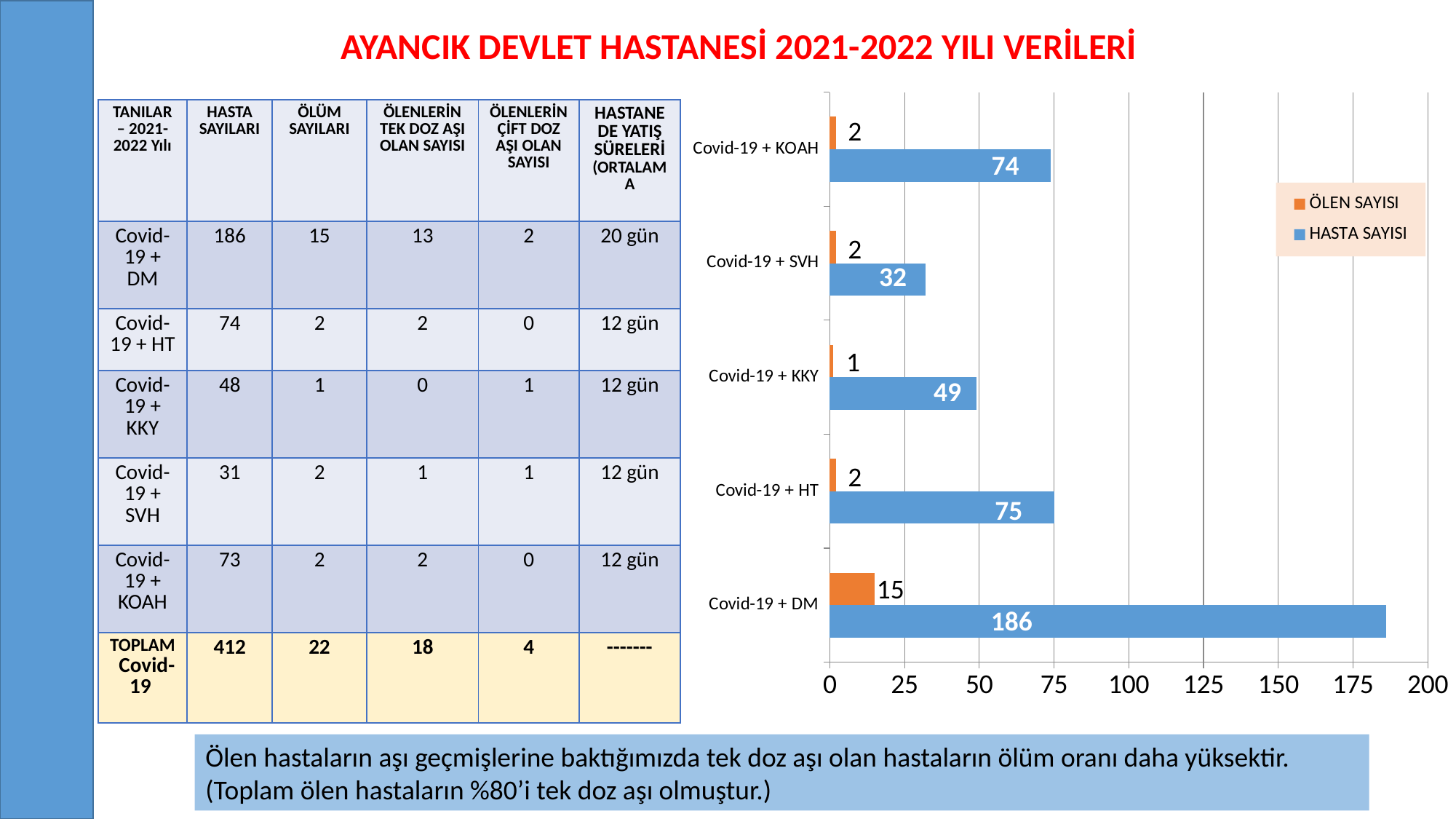
What kind of chart is shown on the right side of the slide? bar chart In the bar chart, which is larger, the HASTA SAYISI for Covid-19 + KKY or for Covid-19 + KOAH? Covid-19 + KOAH In the bar chart, what is the ÖLEN SAYISI value for Covid-19 + KKY? 1 In the bar chart, what is the difference between the HASTA SAYISI values for Covid-19 + DM and Covid-19 + HT? 111 In the bar chart, which category has the highest HASTA SAYISI? Covid-19 + DM In the bar chart, which colour represents the ÖLEN SAYISI series? orange In the bar chart, which category has the lowest HASTA SAYISI? Covid-19 + SVH In the bar chart, is the HASTA SAYISI value for Covid-19 + KKY greater or less than 50? less In the bar chart, what is the HASTA SAYISI value for Covid-19 + DM? 186 How many series does the legend of the bar chart list? 2 In the bar chart, what is the HASTA SAYISI value for Covid-19 + SVH? 32 How many categories are shown in the bar chart? 5